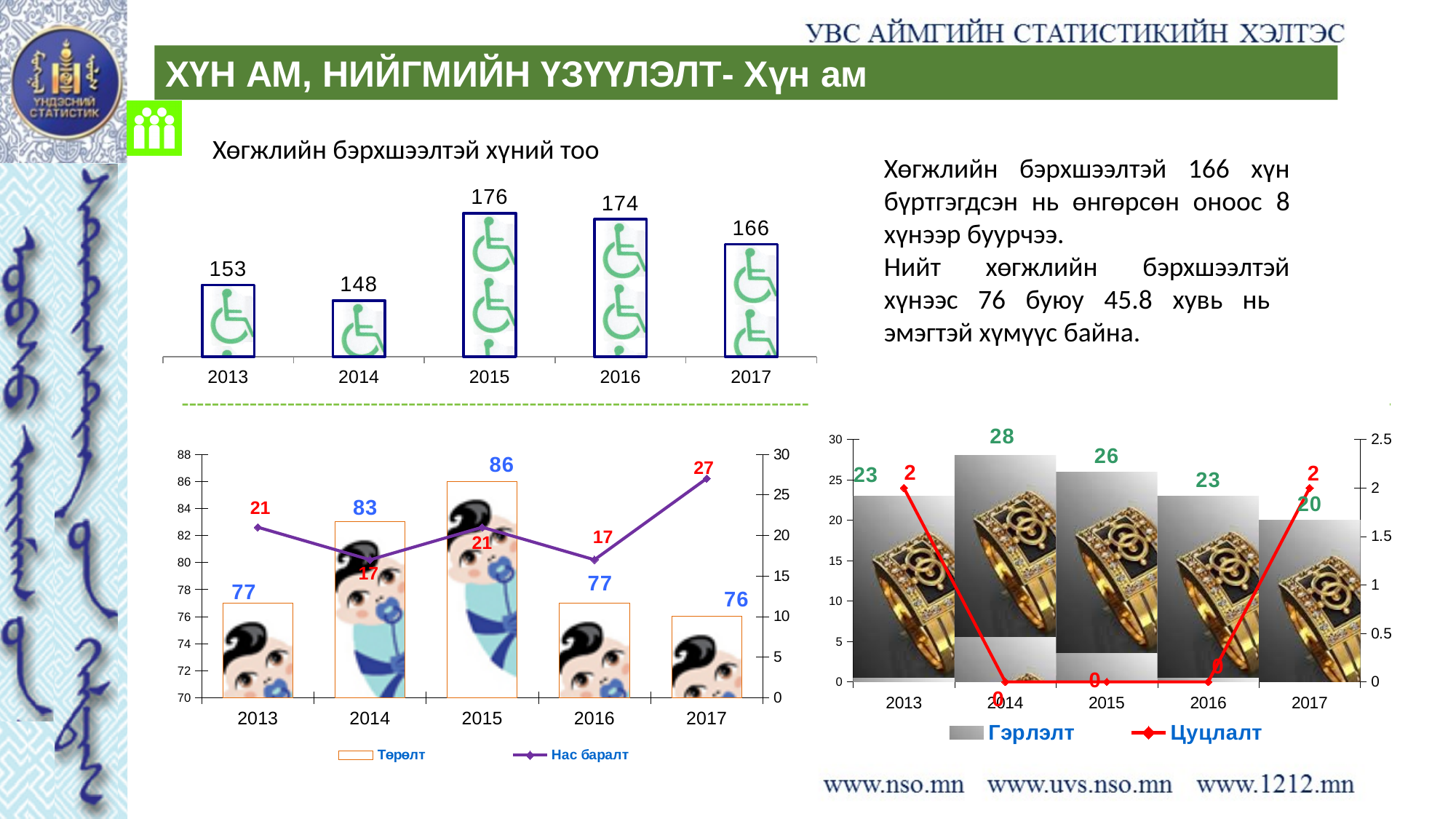
In the bottom-right chart, what is the Гэрлэлт value for 2014? 28 In the bottom-left chart, what is the Нас баралт value for 2017? 27 In the bottom-left chart, which year has the highest Төрөлт value? 2015 In the bottom-left chart, what is the Төрөлт value for 2014? 83 In the bottom-right chart, which year has the lowest Гэрлэлт value? 2017 In the chart titled 'Хөгжлийн бэрхшээлтэй хүний тоо', what is the value for 2015? 176 In the bottom-right chart, what is the Цуцлалт value for 2015? 0 In the chart titled 'Хөгжлийн бэрхшээлтэй хүний тоо', which year has the lowest value? 2014 In the bottom-left chart, how many series does the legend list? 2 In the bottom-right chart, which series is drawn as a red line? Цуцлалт In the chart titled 'Хөгжлийн бэрхшээлтэй хүний тоо', what is the difference between the values for 2016 and 2017? 8 In the chart titled 'Хөгжлийн бэрхшээлтэй хүний тоо', how many years are shown on the x axis? 5